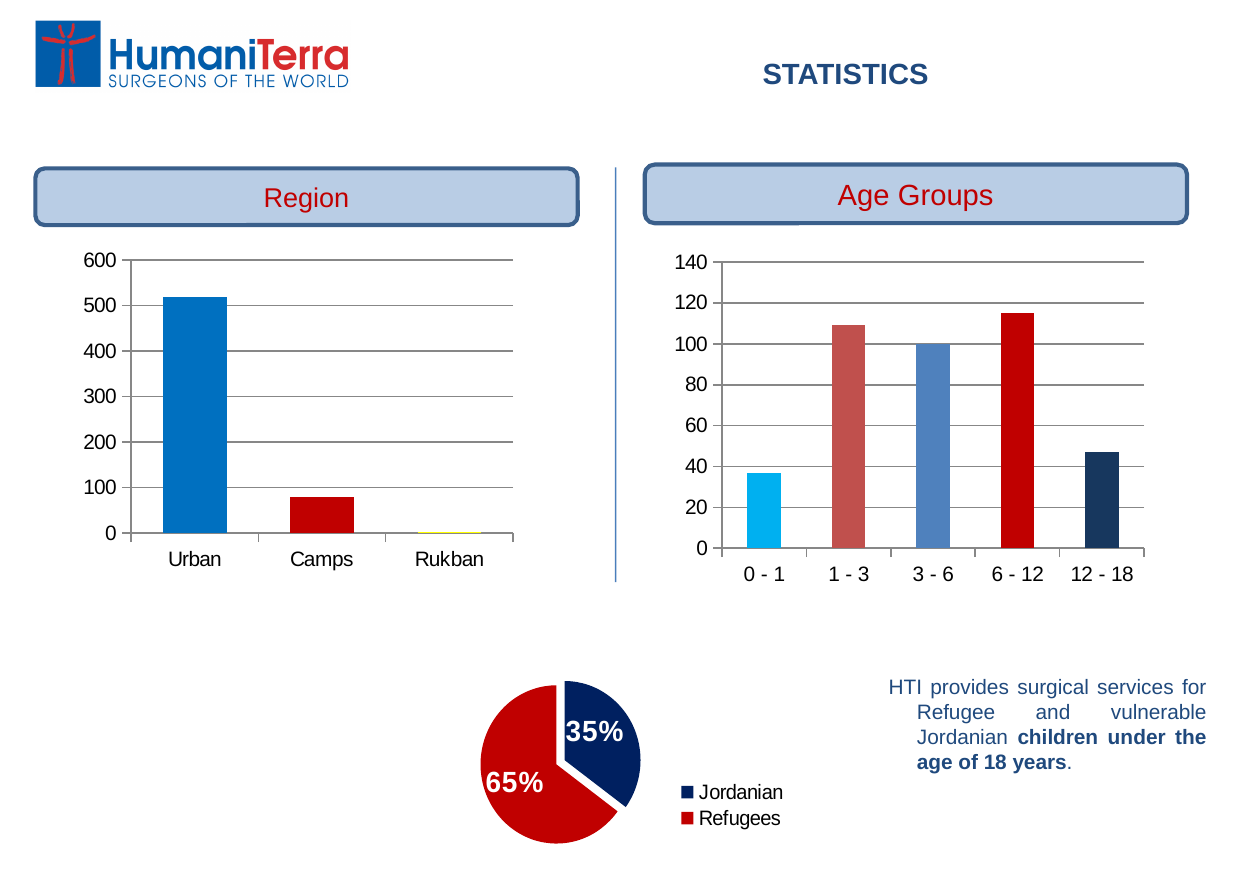
In the Age Groups chart, which age group has the lowest value? 0 - 1 In the Age Groups chart, is the value for 12 - 18 greater or less than 40? greater In the pie chart at the bottom of the slide, what share is Refugees? 65% In the Region chart, which region has the highest value? Urban What kind of chart is the Age Groups chart? bar chart In the Region chart, which region has the lowest value? Rukban In the Age Groups chart, which is larger, the value for 1 - 3 or the value for 12 - 18? 1 - 3 In the Region chart, is the value for Camps greater or less than 100? less How many age groups are shown in the Age Groups chart? 5 In the Region chart, is the value for Urban greater or less than 500? greater In the Age Groups chart, which age group has the highest value? 6 - 12 How many regions are shown in the Region chart? 3